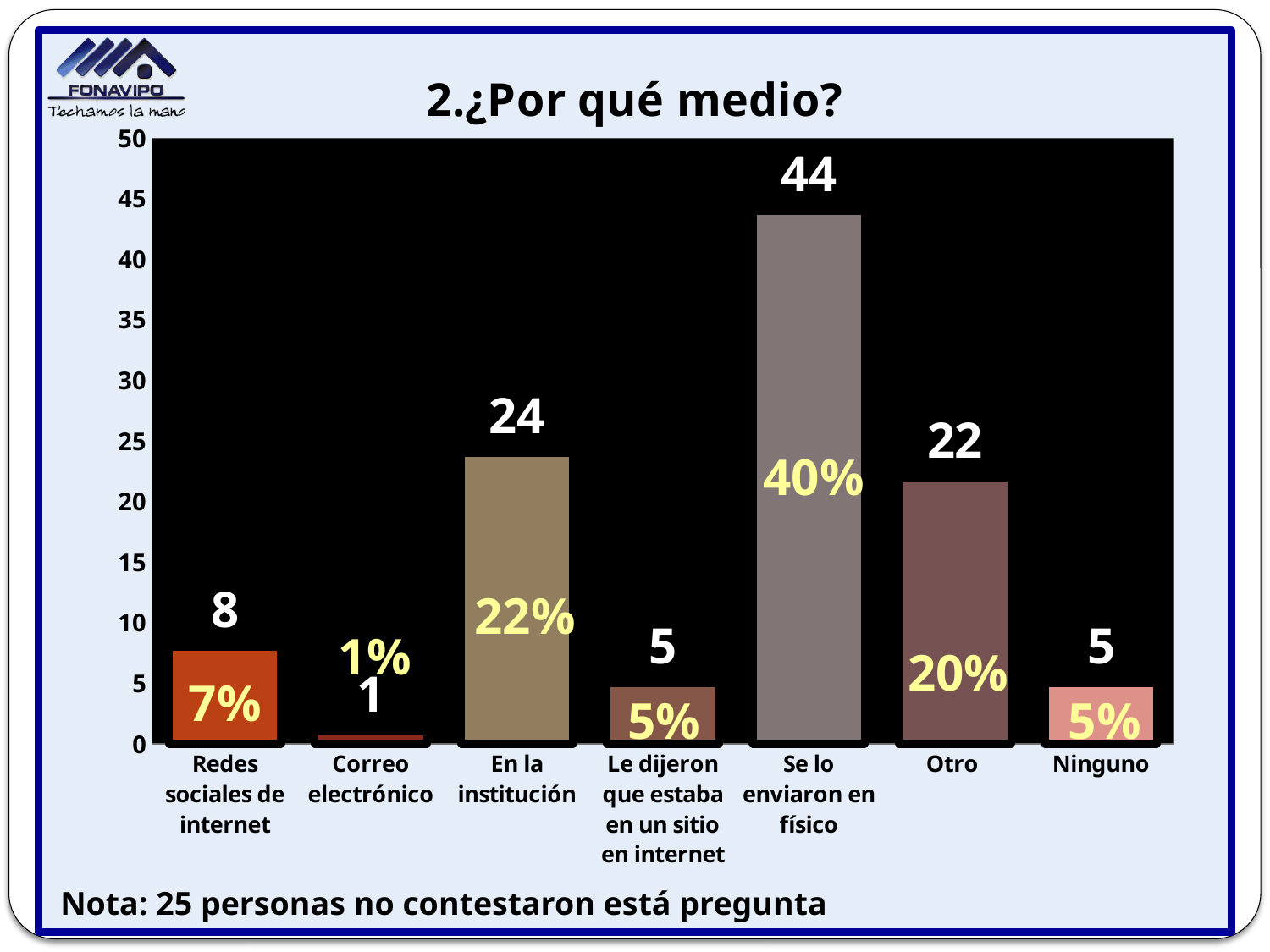
What is the value for "Correo electrónico"? 1 How many categories are shown on the x axis? 7 What is the difference between the values for "Se lo enviaron en físico" and "Otro"? 22 What is the value for "Se lo enviaron en físico"? 44 Is the value for "En la institución" greater or less than 20? greater Which is larger, the value for "Redes sociales de internet" or the value for "Ninguno"? Redes sociales de internet What is the title of the chart? 2.¿Por qué medio? Which category has the lowest value? Correo electrónico What is the value for "En la institución"? 24 Which category has the highest value? Se lo enviaron en físico What kind of chart is this? bar chart What percentage is shown on the "Otro" bar? 20%